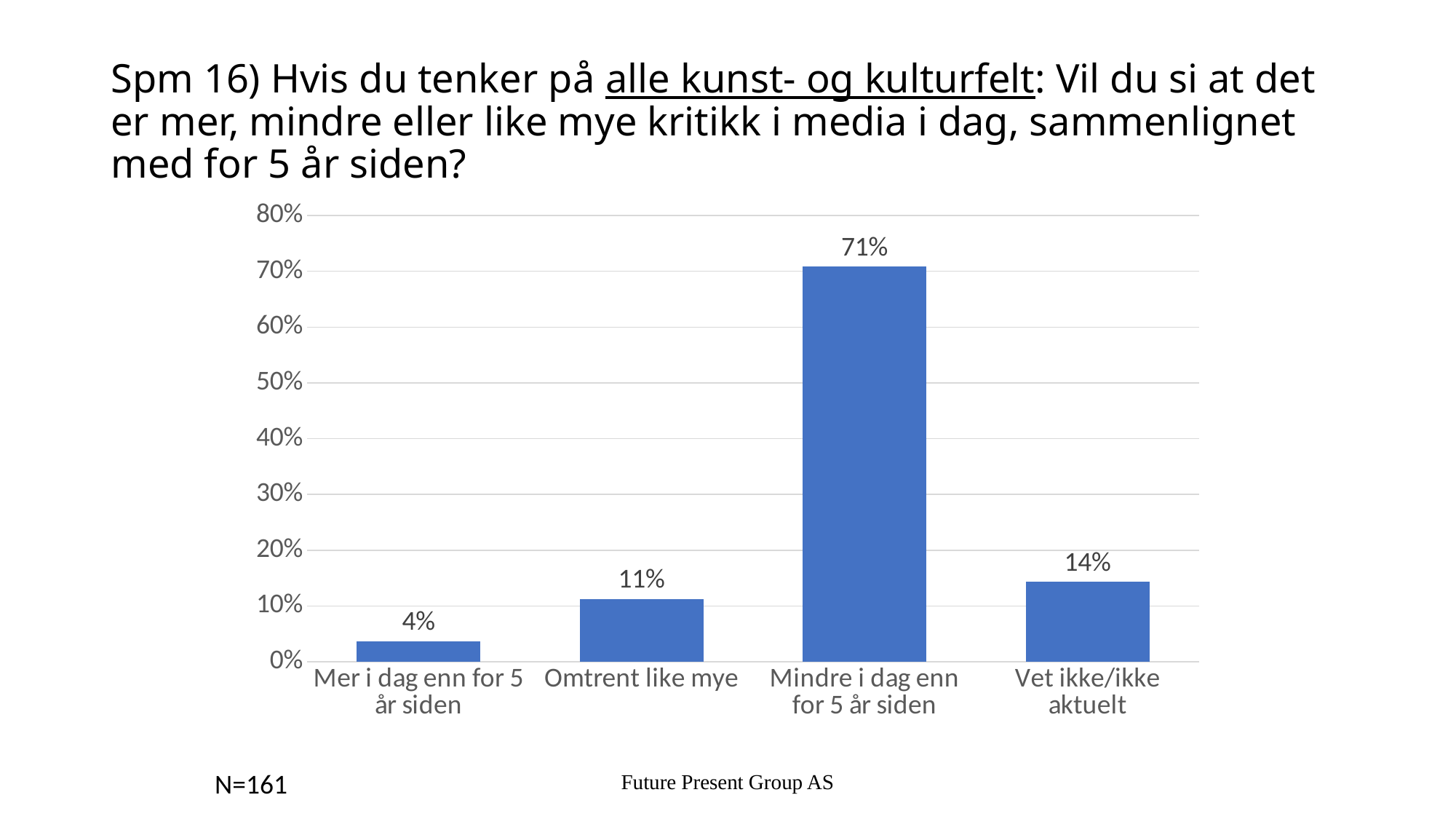
Is the value for "Mindre i dag enn for 5 år siden" greater or less than 60%? greater What is the difference between "Mindre i dag enn for 5 år siden" and "Vet ikke/ikke aktuelt"? 57% What is the value for "Mindre i dag enn for 5 år siden"? 71% Which category has the lowest value? Mer i dag enn for 5 år siden How many categories are shown on the x axis? 4 What is the value for "Mer i dag enn for 5 år siden"? 4% Which is larger, "Omtrent like mye" or "Vet ikke/ikke aktuelt"? Vet ikke/ikke aktuelt What is the value for "Omtrent like mye"? 11% What is the difference between "Vet ikke/ikke aktuelt" and "Omtrent like mye"? 3% What is the value for "Vet ikke/ikke aktuelt"? 14% What kind of chart is shown on the slide? Bar chart Which category has the highest value? Mindre i dag enn for 5 år siden